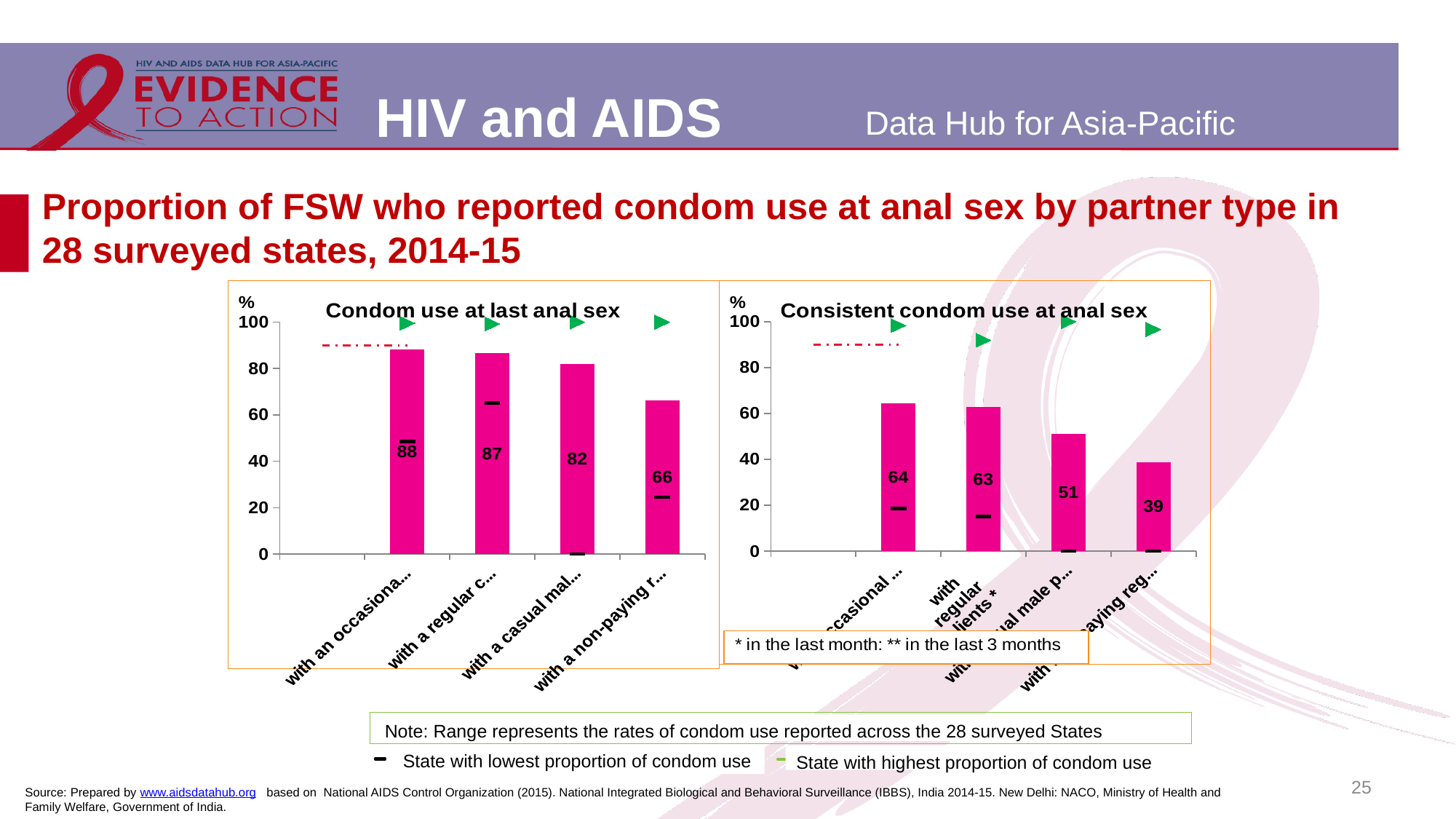
Which is larger: the third bar in the 'Condom use at last anal sex' chart or the third bar in the 'Consistent condom use at anal sex' chart? Condom use at last anal sex (82) In the 'Consistent condom use at anal sex' chart, what is the difference between the third bar (51) and the fourth bar (39)? 12 In the 'Condom use at last anal sex' chart, what is the value of the bar labelled 'with a non-paying r...'? 66 In the 'Consistent condom use at anal sex' chart, do the values rise or fall from left to right? Fall In the 'Condom use at last anal sex' chart, what is the value of the first bar (with an occasional...)? 88 In the 'Consistent condom use at anal sex' chart, what is the value of the last bar (with a non-paying reg...)? 39 In the 'Condom use at last anal sex' chart, which bar has the lowest value? with a non-paying r... (66) In the 'Consistent condom use at anal sex' chart, which bar has the highest value? with an occasional... (64) In the 'Condom use at last anal sex' chart, what is the difference between the first bar (88) and the last bar (66)? 22 How many bars are plotted in the 'Consistent condom use at anal sex' chart? 4 In the 'Consistent condom use at anal sex' chart, what is the value of the first bar (with an occasional...)? 64 What type of chart is the 'Condom use at last anal sex' chart? Bar chart